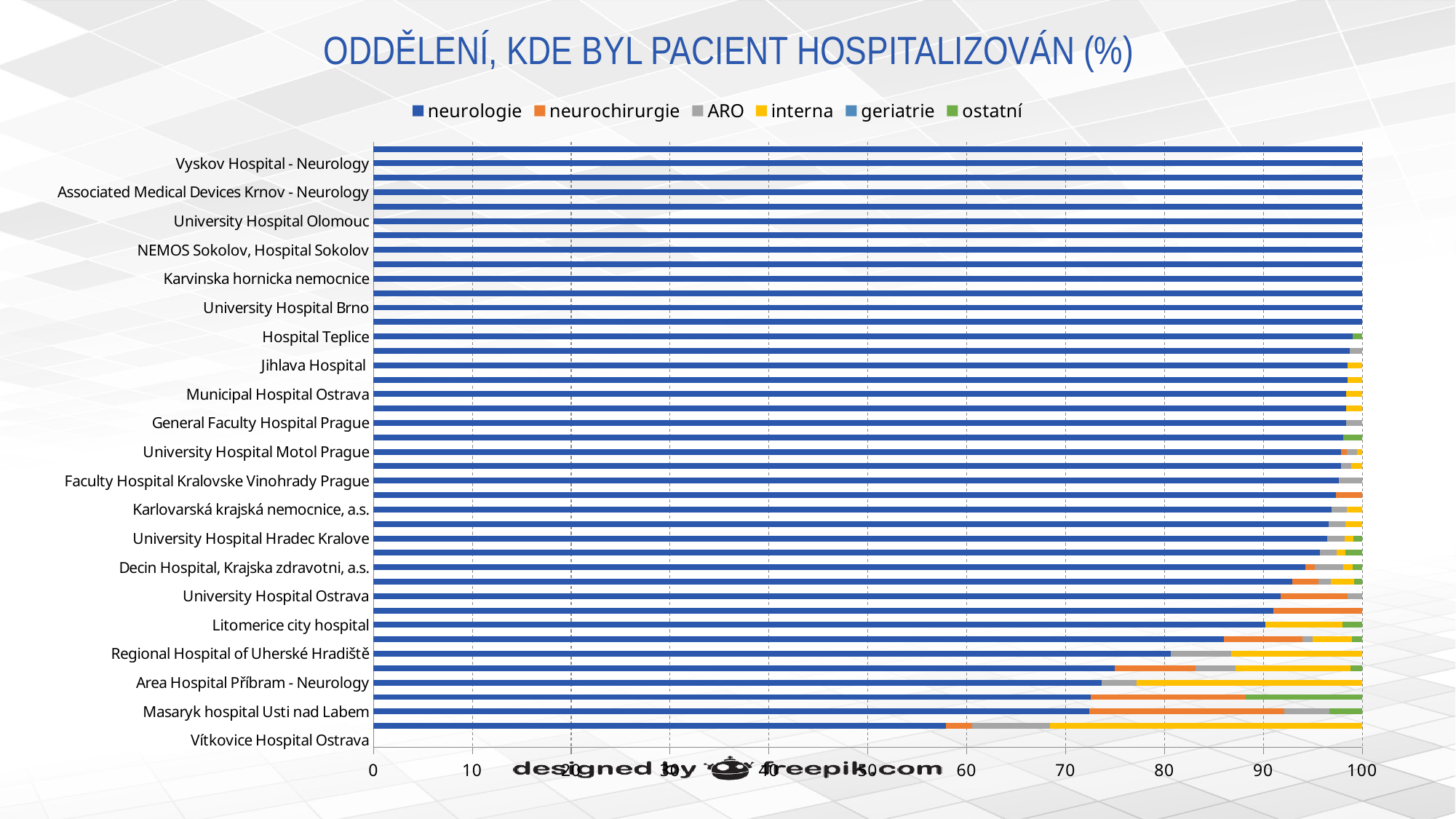
Which colour represents the 'interna' series in the legend? yellow Does the neurologie share increase or decrease going from the top of the chart to the bottom? decrease How many series does the legend list? 6 What is the title of the chart? ODDĚLENÍ, KDE BYL PACIENT HOSPITALIZOVÁN (%) Is the neurologie value for Masaryk hospital Usti nad Labem greater or less than 70? greater Is the neurologie value for University Hospital Ostrava greater or less than 90? greater What kind of chart is shown on the slide? bar chart What is the neurologie value for Vyskov Hospital - Neurology? 100